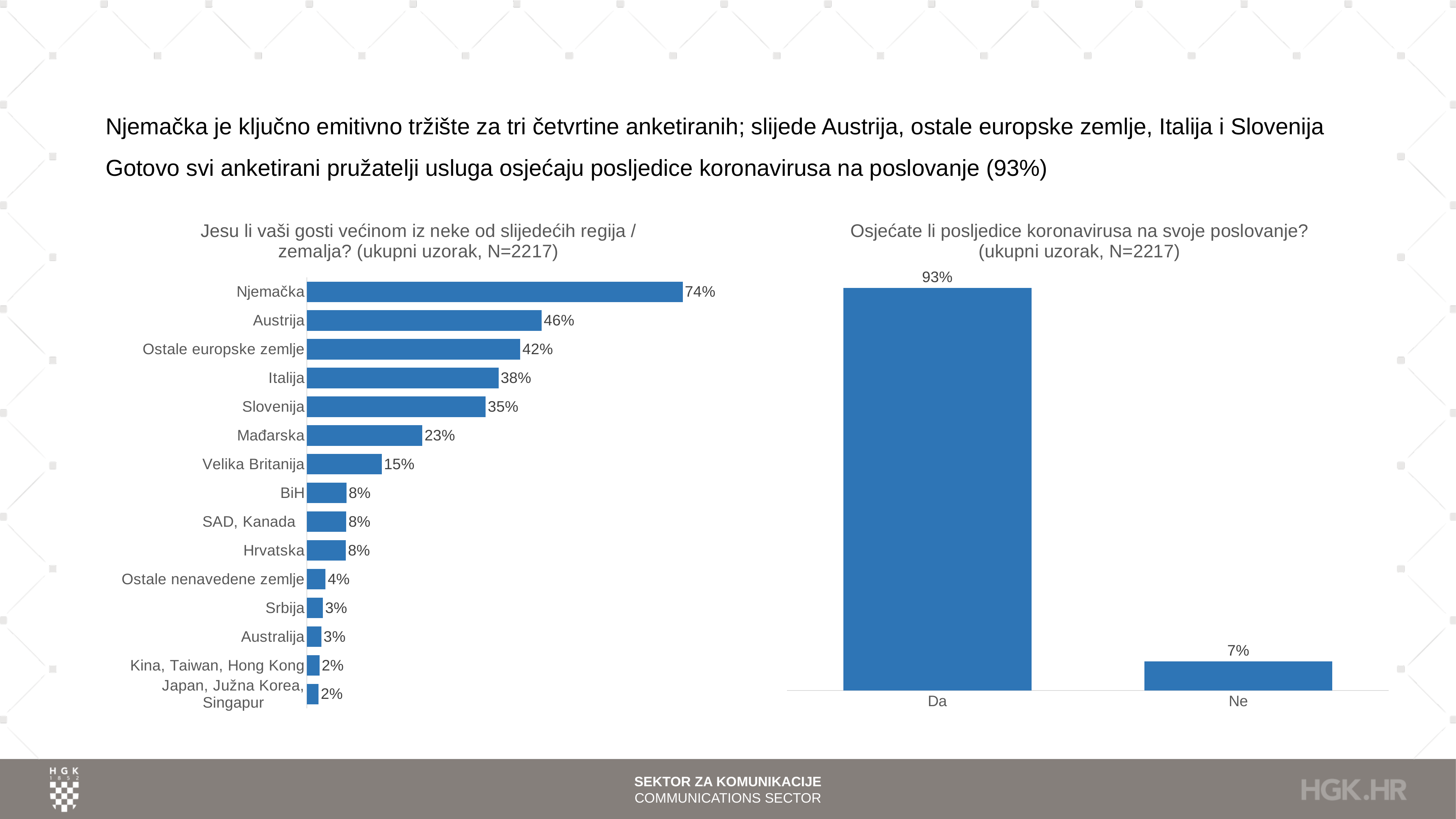
In the left chart (Jesu li vaši gosti većinom iz neke od slijedećih regija / zemalja?), what is the value for Njemačka? 74% In the right chart, what is the value for Ne? 7% What kind of chart is the left chart? Bar chart In the left chart, how many categories are shown? 15 In the right chart (Osjećate li posljedice koronavirusa na svoje poslovanje?), what is the value for Da? 93% In the left chart, what is the value for Velika Britanija? 15% In the right chart, what is the difference between the values for Da and Ne? 86% In the left chart, what is the difference between the values for Austrija and Italija? 8% In the right chart, how many categories are shown? 2 In the left chart, what is the value for Slovenija? 35% In the left chart, which is larger, the value for Mađarska or the value for Velika Britanija? Mađarska In the left chart, which category has the highest value? Njemačka